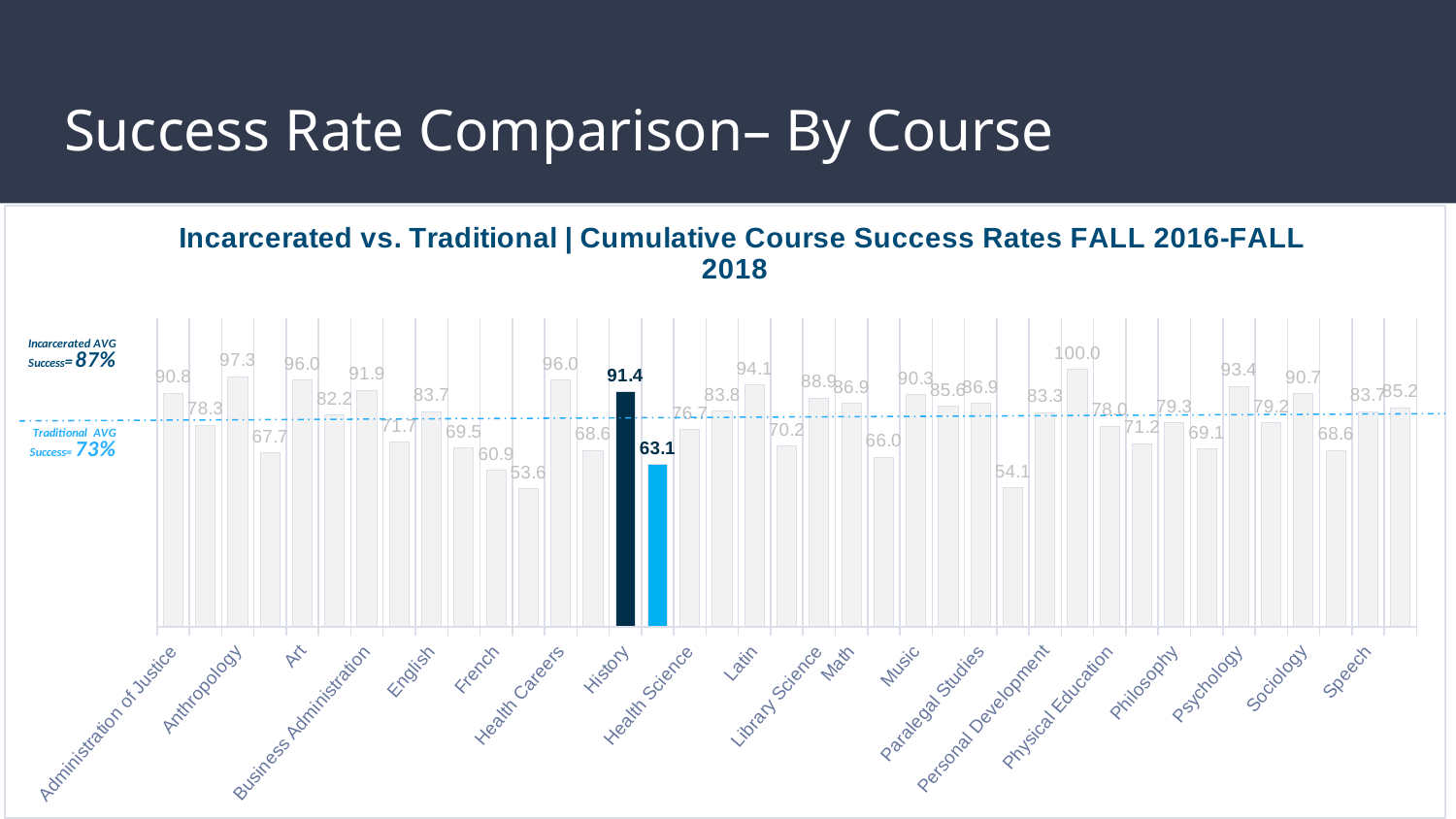
What is the Traditional AVG Success rate shown on the chart? 73% What is the value of the light blue bar for History? 63.1 What is the lowest value labeled on any bar in the chart? 53.6 Which course is highlighted with coloured bars in the chart? History For History, which bar is larger, the dark navy bar or the light blue bar? the dark navy bar How many courses are listed along the x axis of the chart? 20 What is the difference between the two History bars (91.4 and 63.1)? 28.3 What is the title of the chart? Incarcerated vs. Traditional | Cumulative Course Success Rates FALL 2016-FALL 2018 What is the Incarcerated AVG Success rate shown on the chart? 87% What is the value of the dark navy bar for History? 91.4 What is the highest value labeled on any bar in the chart? 100.0 What kind of chart is shown on the slide? bar chart